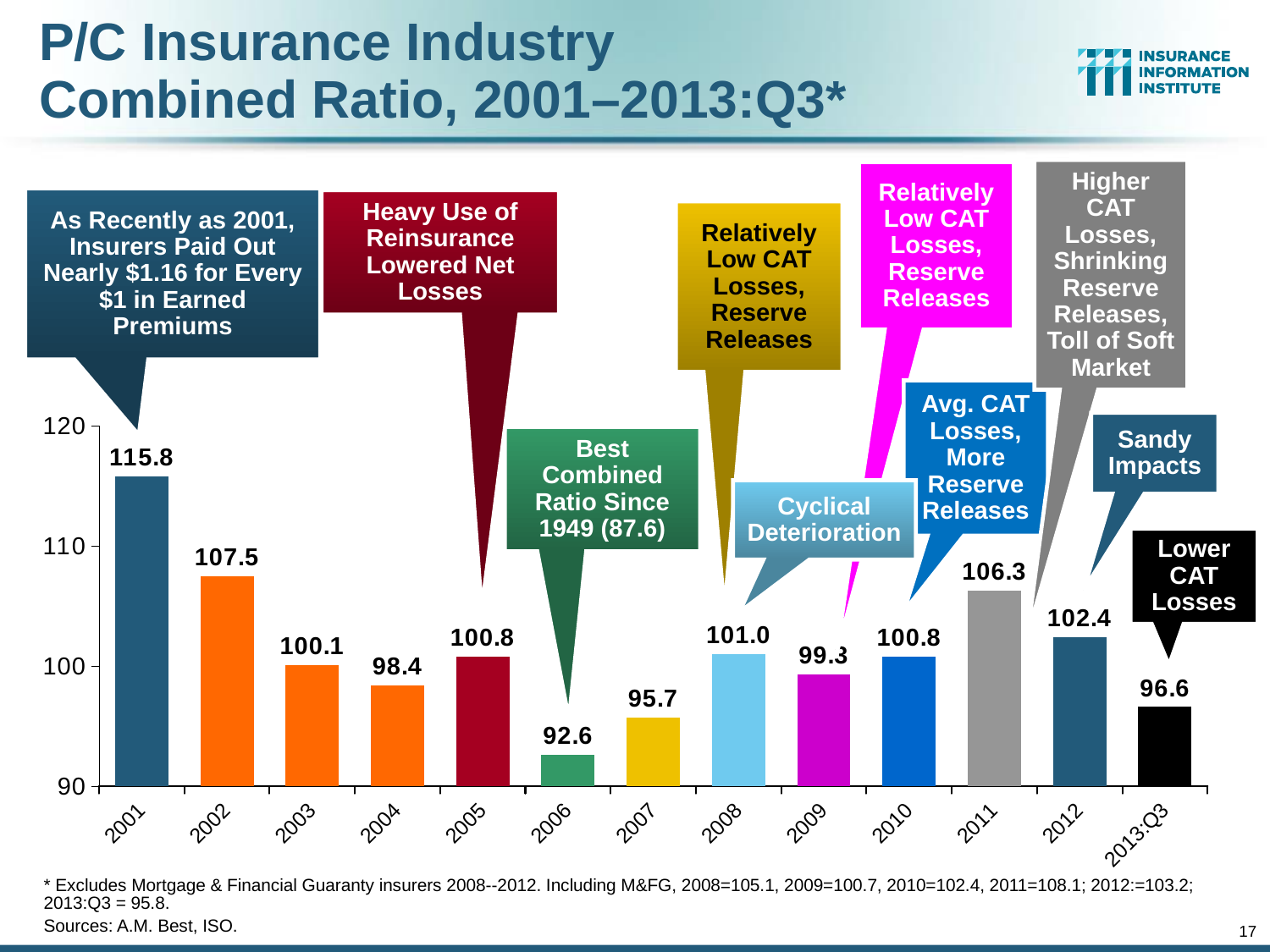
Which is larger, the combined ratio for 2008 or for 2009? 2008 Is the combined ratio for 2007 greater or less than 100? less What is the difference between the combined ratio in 2001 and in 2002? 8.3 Which year has the highest combined ratio? 2001 What is the difference between the combined ratio in 2011 and in 2012? 3.9 What is the combined ratio for 2001? 115.8 How many bars are plotted in the chart? 13 What kind of chart is shown on the slide? bar chart What is the combined ratio for 2006? 92.6 What is the title of the slide's chart? P/C Insurance Industry Combined Ratio, 2001–2013:Q3* Which year has the lowest combined ratio? 2006 What is the combined ratio for 2013:Q3? 96.6